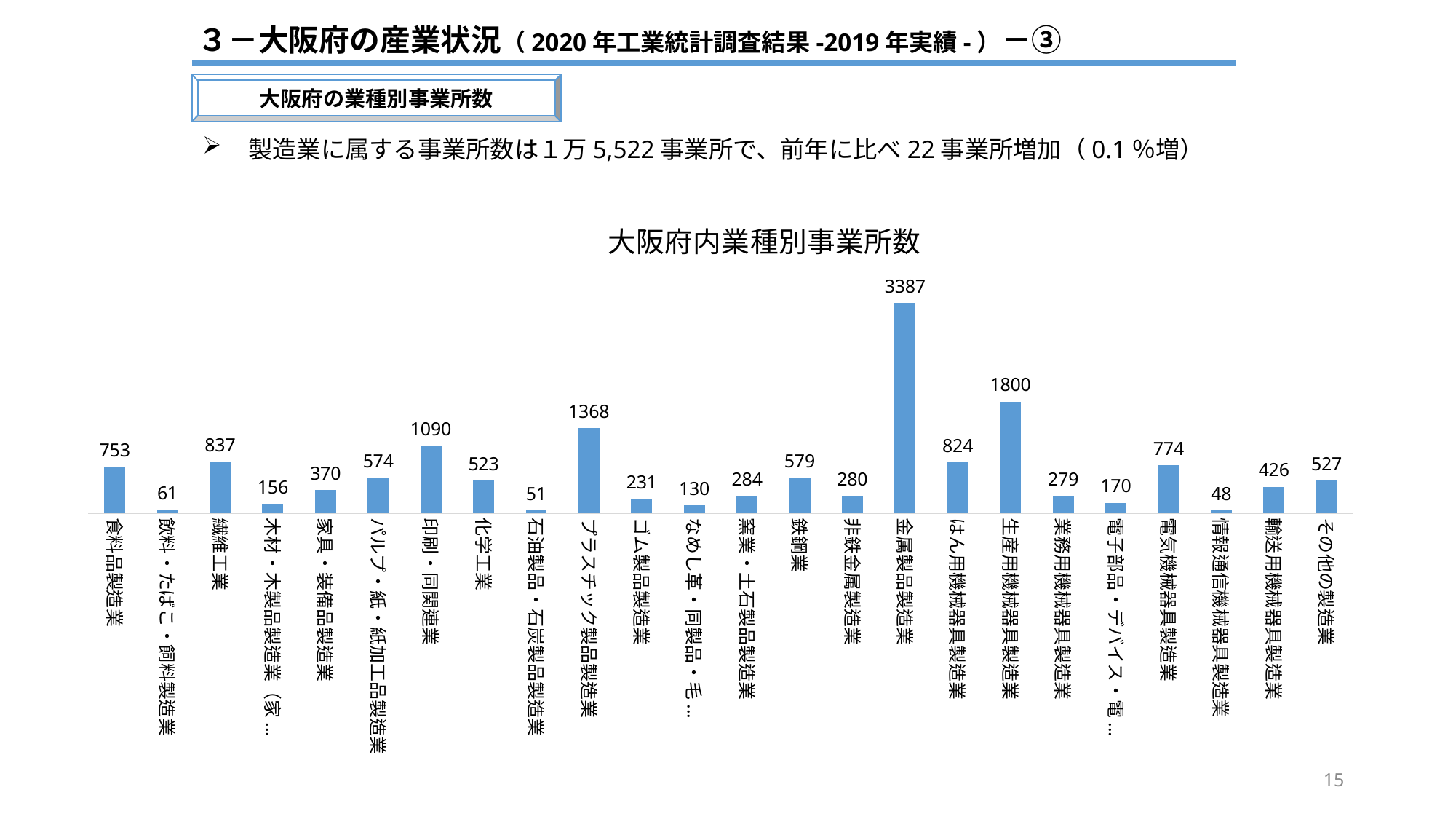
What is the value for 輸送用機械器具製造業? 426 Which is larger, the value for はん用機械器具製造業 or the value for 電気機械器具製造業? はん用機械器具製造業 Which is larger, the value for 鉄鋼業 or the value for 化学工業? 鉄鋼業 Which category has the highest value? 金属製品製造業 Which category has the lowest value? 情報通信機械器具製造業 What is the title of the chart? 大阪府内業種別事業所数 What kind of chart is shown on the slide? Bar chart What is the value for 印刷・同関連業? 1090 What is the value for 金属製品製造業 in the chart? 3387 What is the difference between the values for 繊維工業 and 食料品製造業? 84 What is the difference between the values for 生産用機械器具製造業 and プラスチック製品製造業? 432 How many categories are shown in the chart? 24